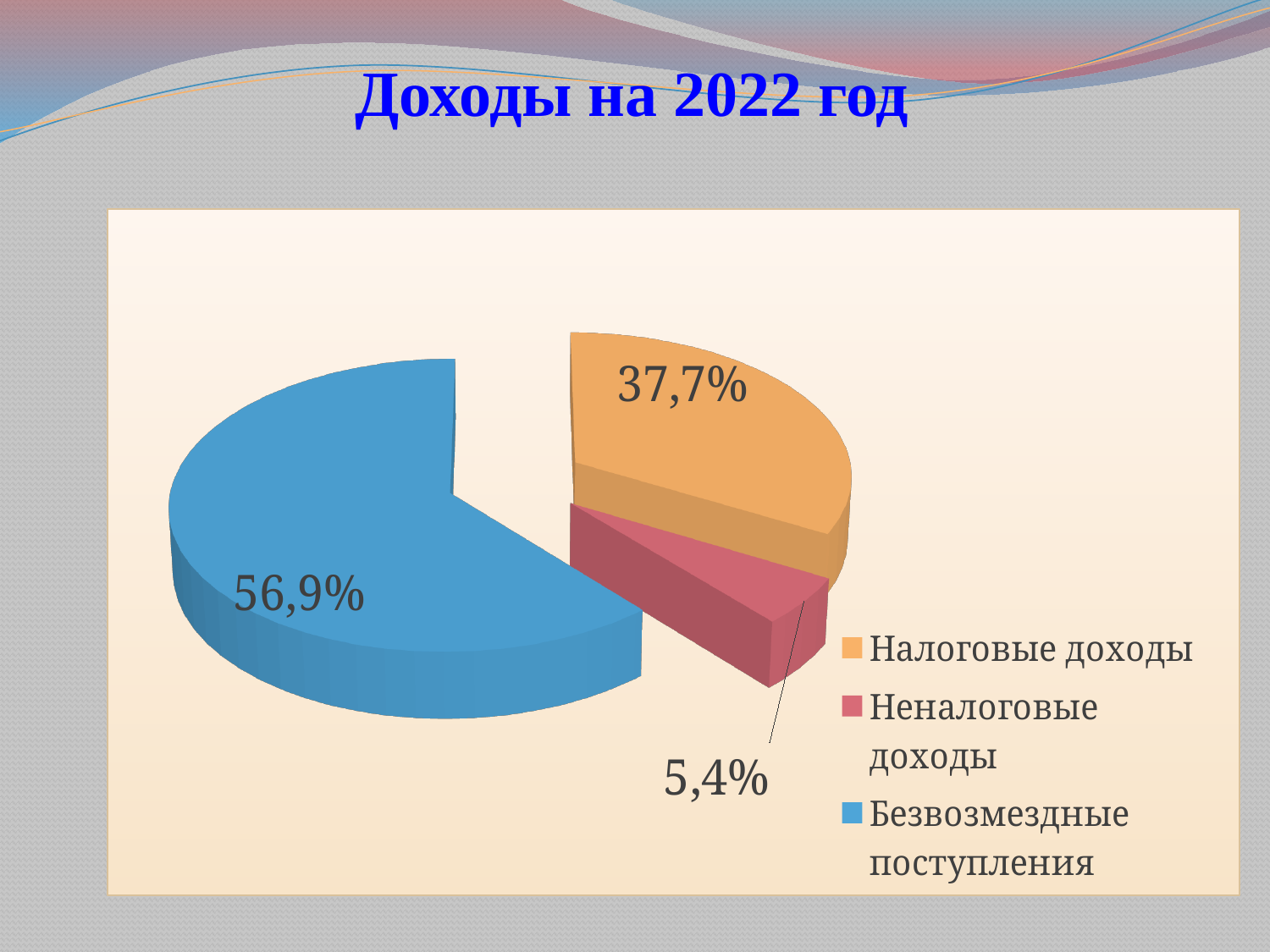
What is the title of the slide? Доходы на 2022 год What is the share for Неналоговые доходы? 5,4% Which category has the largest share of the pie? Безвозмездные поступления What is the difference in percentage points between Безвозмездные поступления and Налоговые доходы? 19,2 What is the share for Налоговые доходы? 37,7% What is the share for Безвозмездные поступления? 56,9% What colour is the slice for Безвозмездные поступления? blue What is the difference in percentage points between Налоговые доходы and Неналоговые доходы? 32,3 Which is larger, the share for Налоговые доходы or the share for Неналоговые доходы? Налоговые доходы Which category has the smallest share of the pie? Неналоговые доходы How many slices does the pie chart have? 3 What kind of chart is shown on the slide? pie chart